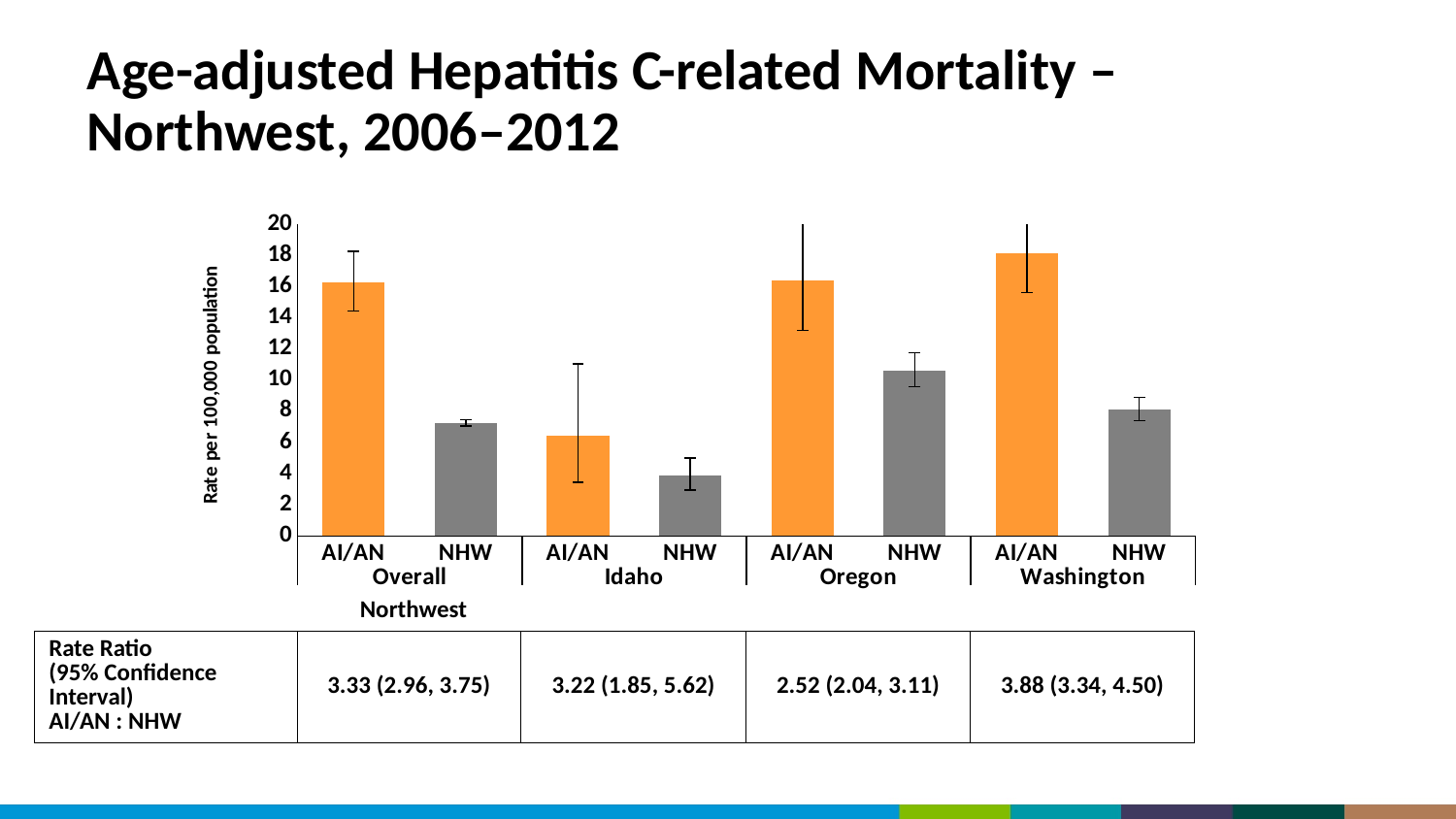
How many state/region groups are shown along the x axis of the chart? 4 Is the value for Oregon NHW greater or less than 8? greater Is the value for Washington AI/AN greater or less than 16? greater Is the value for Overall NHW greater or less than 8? less Which bar has the highest mortality rate in the chart? Washington AI/AN Which is larger, the NHW rate for Oregon or the NHW rate for Washington? Oregon How many bars are plotted in the chart? 8 What is the label of the y axis of the chart? Rate per 100,000 population Which bar has the lowest mortality rate in the chart? Idaho NHW What kind of chart is shown on the slide? bar chart